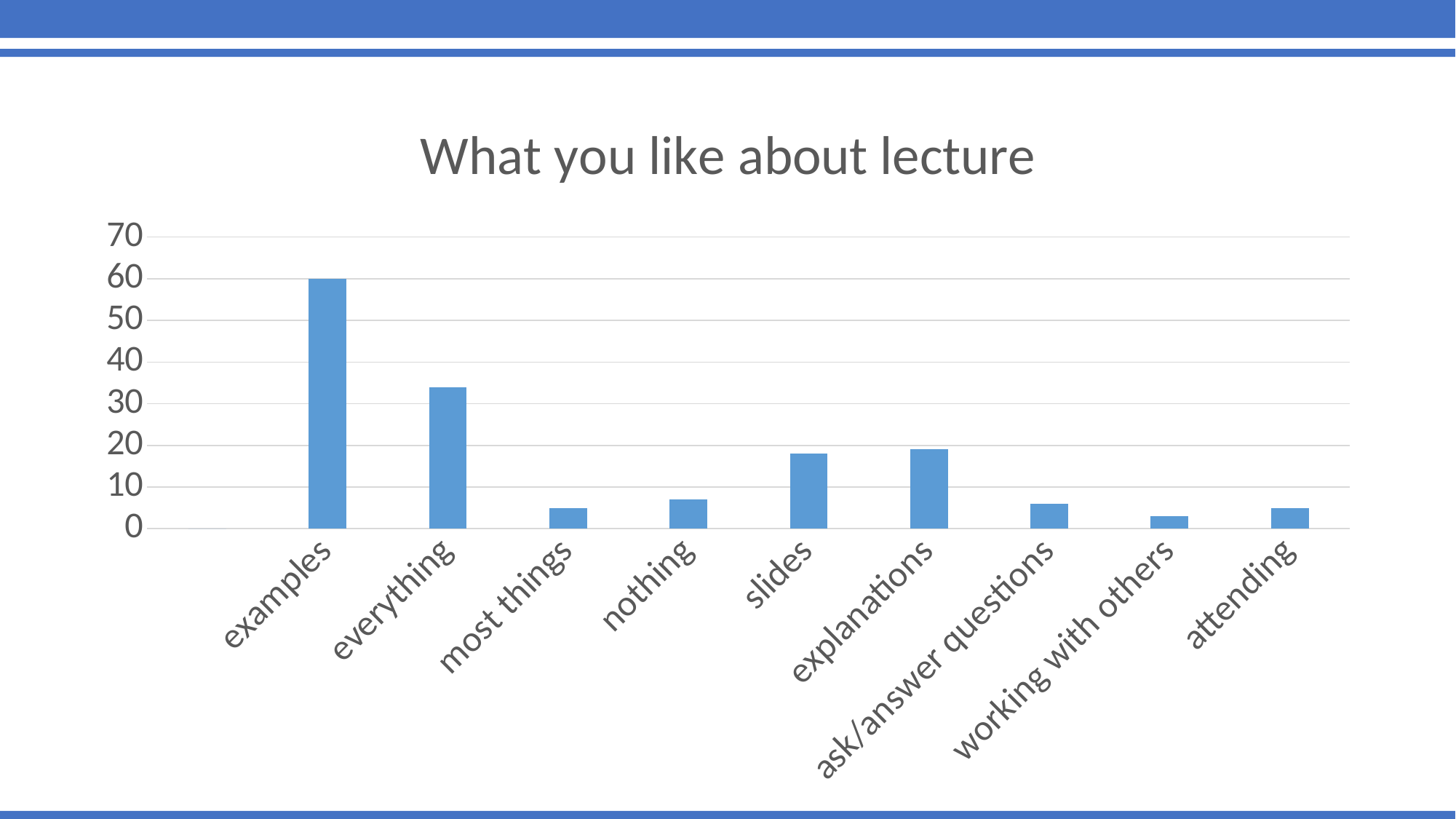
Which category has the highest value? examples Is the value for everything greater or less than 40? less How many categories are shown on the x axis of the chart? 9 What is the value for examples? 60 Which is larger, the value for slides or the value for nothing? slides Is the value for nothing greater or less than 10? less What kind of chart is shown on the slide? bar chart Is the value for everything greater or less than 30? greater What is the title of the chart? What you like about lecture Which is larger, the value for examples or the value for everything? examples Which category has the lowest value? working with others